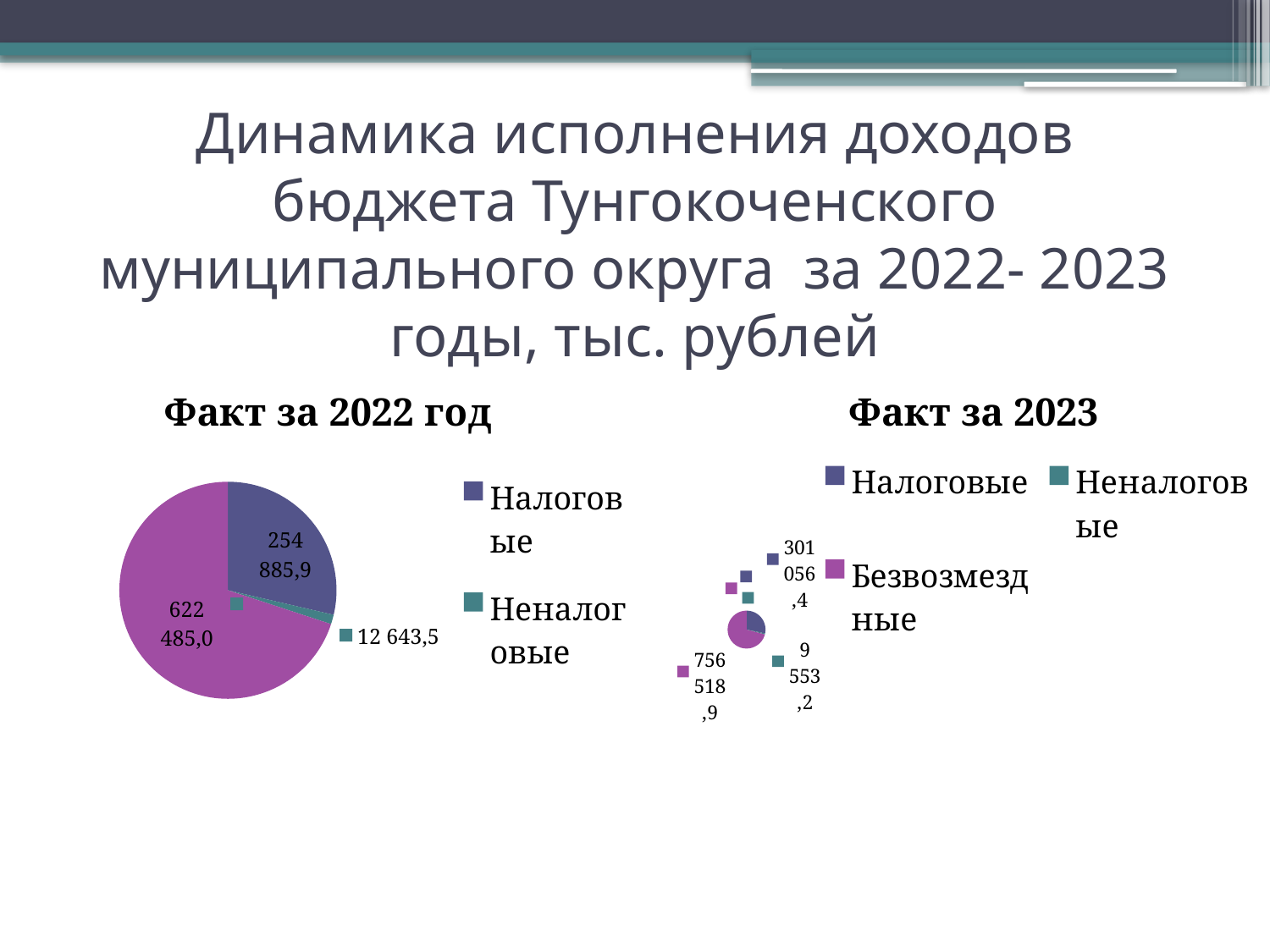
In the chart 'Факт за 2023', which category has the largest value? Безвозмездные In the chart 'Факт за 2023', which category has the smallest value? Неналоговые In the chart 'Факт за 2023', what is the value for Неналоговые? 9 553,2 Is the value for Налоговые larger in the chart 'Факт за 2022 год' or in the chart 'Факт за 2023'? Факт за 2023 In the chart 'Факт за 2022 год', what is the value for Неналоговые? 12 643,5 In the chart 'Факт за 2023', what is the value for Безвозмездные? 756 518,9 How many entries does the legend of the chart 'Факт за 2023' list? 3 In the chart 'Факт за 2023', what is the difference between Налоговые and Неналоговые? 291 503,2 In the chart 'Факт за 2022 год', what is the value of the largest slice? 622 485,0 In the chart 'Факт за 2022 год', what is the value for Налоговые? 254 885,9 In the chart 'Факт за 2023', what is the value for Налоговые? 301 056,4 What kind of chart is 'Факт за 2022 год'? Pie chart